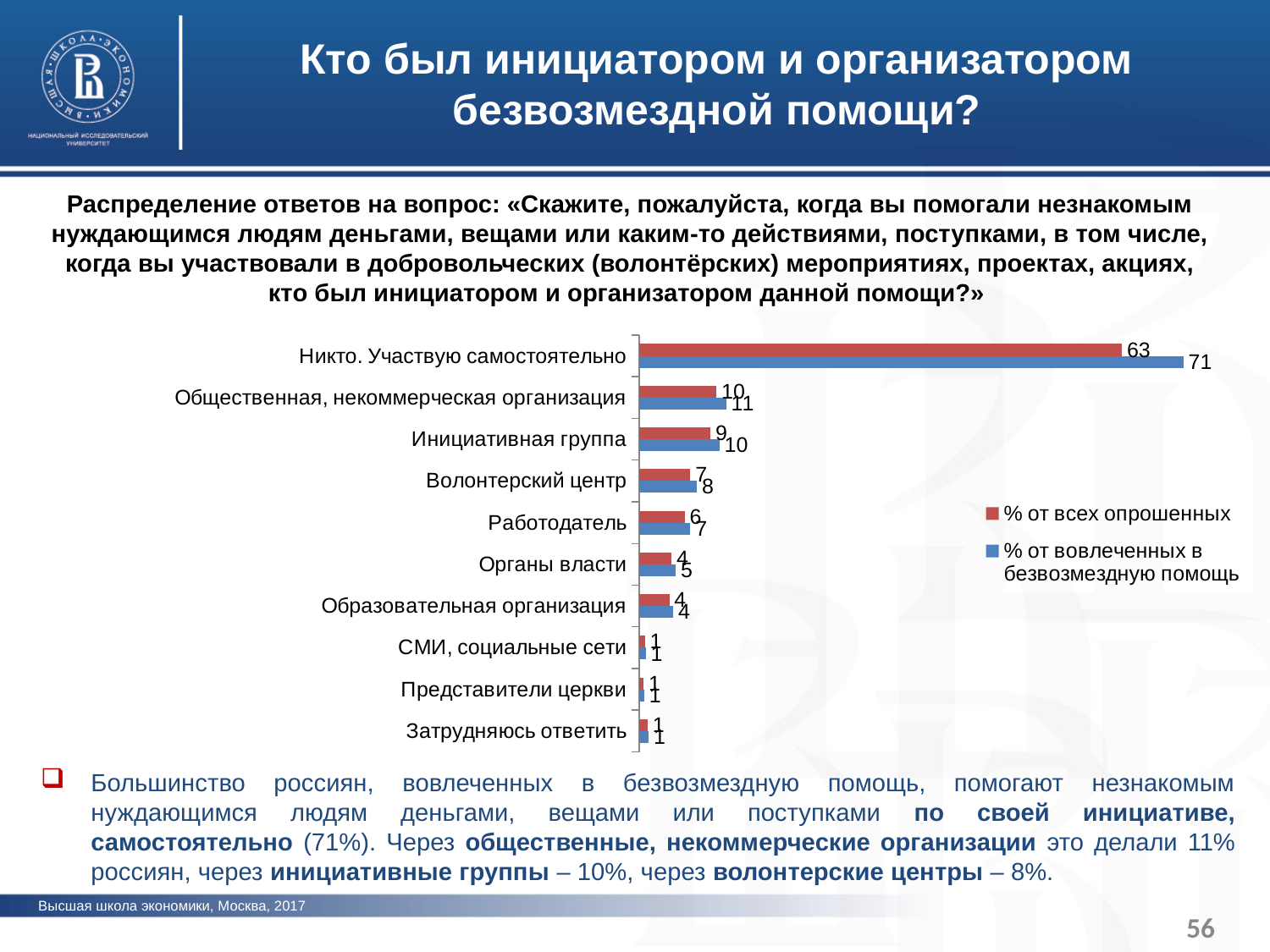
How many categories are shown on the chart? 10 Which is larger for «Инициативная группа»: the value for «% от всех опрошенных» or for «% от вовлеченных в безвозмездную помощь»? % от вовлеченных в безвозмездную помощь How many series does the legend list? 2 What kind of chart is shown on the slide? bar chart What is the value for «Работодатель» in the series «% от всех опрошенных»? 6 What is the difference between «Общественная, некоммерческая организация» and «Органы власти» in the series «% от вовлеченных в безвозмездную помощь»? 6 Which colour represents the series «% от всех опрошенных»? red What is the value for «Никто. Участвую самостоятельно» in the series «% от всех опрошенных»? 63 What is the value for «Волонтерский центр» in the series «% от вовлеченных в безвозмездную помощь»? 8 What is the difference between the two series values for «Никто. Участвую самостоятельно»? 8 What is the value for «Никто. Участвую самостоятельно» in the series «% от вовлеченных в безвозмездную помощь»? 71 Which category has the highest value in the series «% от вовлеченных в безвозмездную помощь»? Никто. Участвую самостоятельно